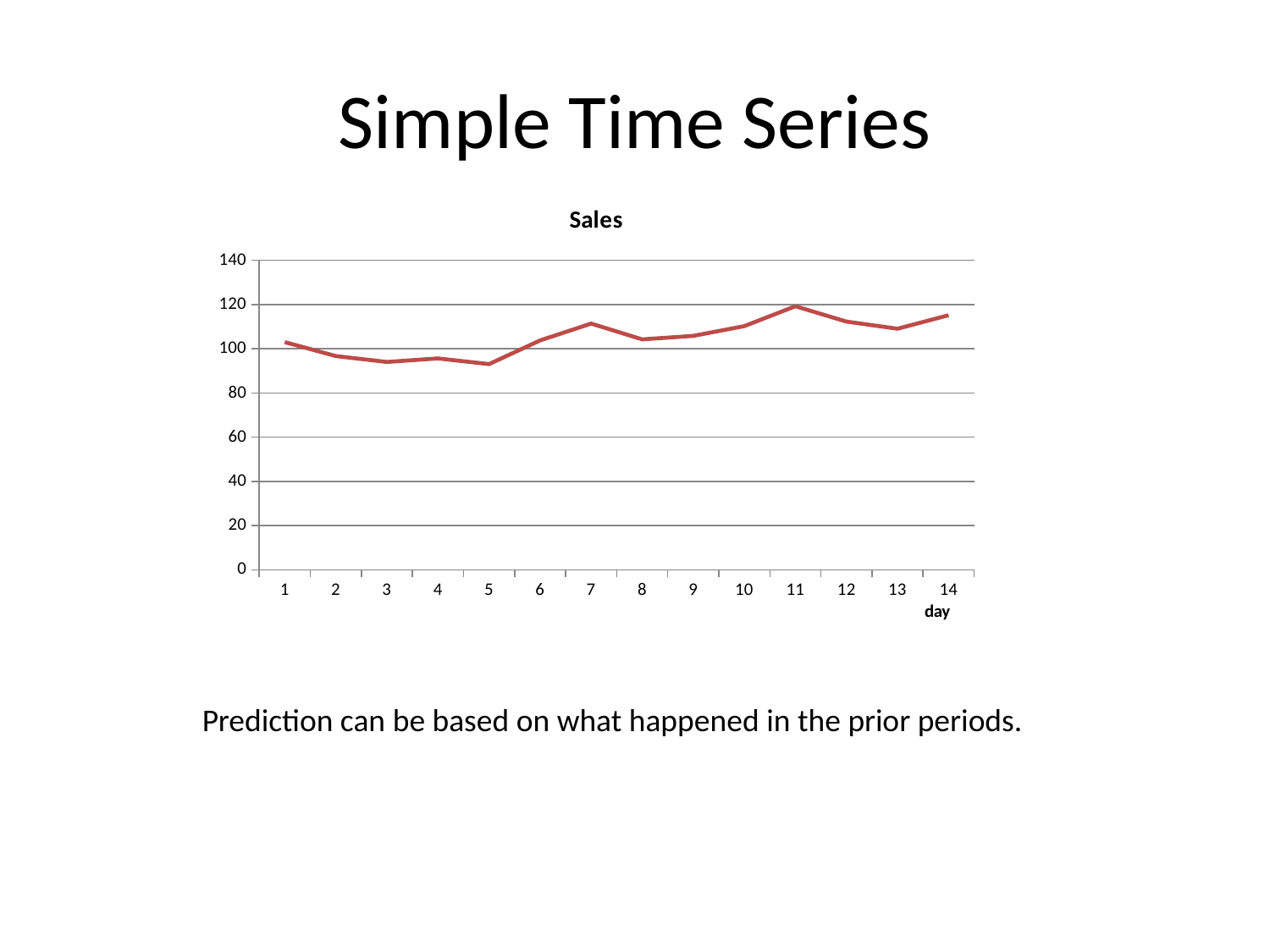
Is the sales value for day 3 greater or less than 100? less Which day has the larger sales value, day 11 or day 5? day 11 How many days are plotted on the x axis? 14 Do sales rise or fall from day 1 to day 5? fall Is the sales value for day 5 greater or less than 100? less What is the title of the chart? Sales On which day is the sales value highest? 11 What kind of chart is shown on the slide? line chart Which day has the larger sales value, day 3 or day 7? day 7 Is the sales value for day 7 greater or less than 100? greater What is the label on the x axis of the chart? day